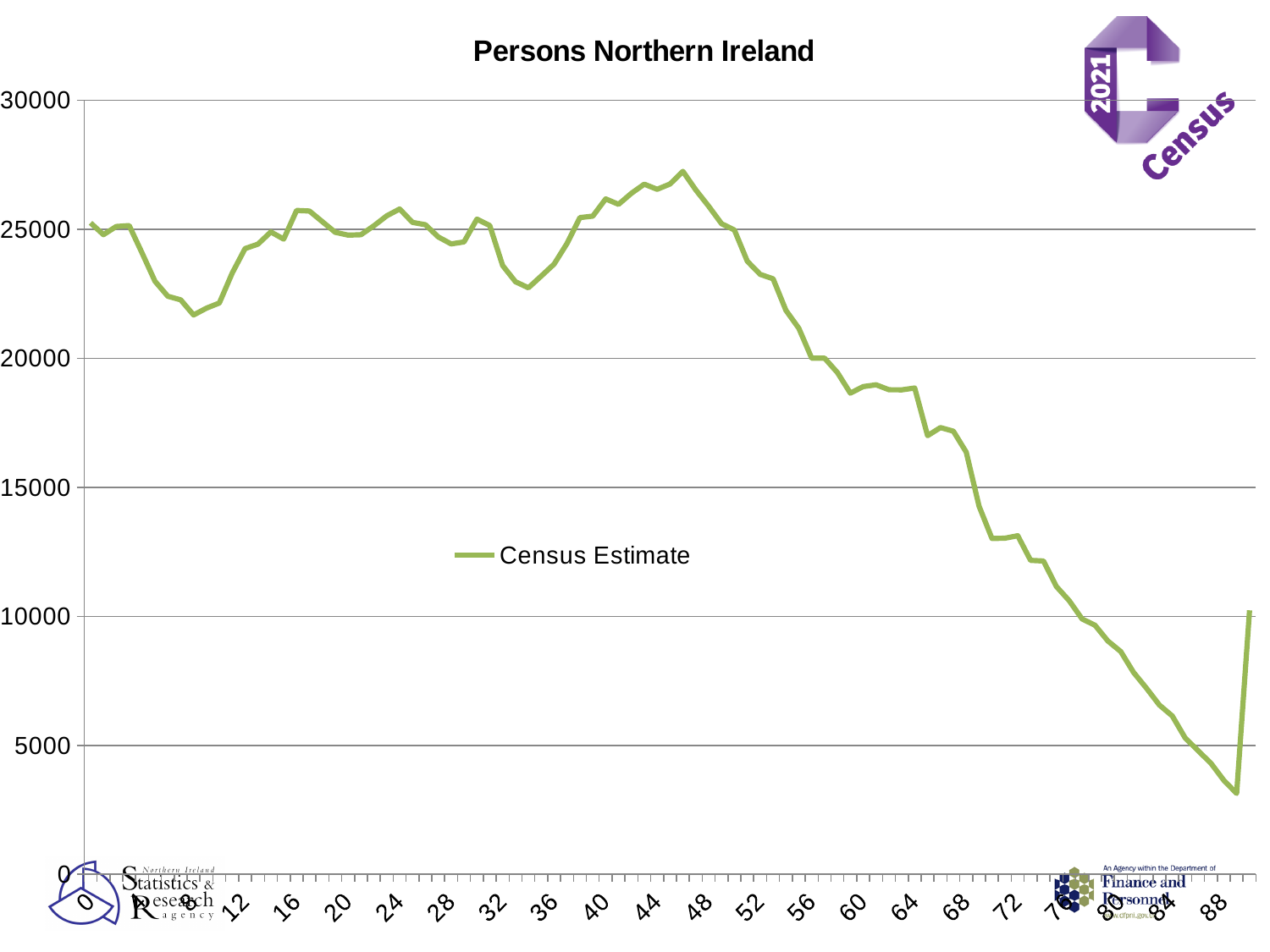
Is the Census Estimate value at age 20 greater or less than 20000? greater Is the Census Estimate value at age 80 greater or less than 10000? less What is the title of the chart? Persons Northern Ireland Do the Census Estimate values rise or fall between age 48 and age 88? fall What kind of chart is shown on the slide? line chart Is the Census Estimate value at age 0 greater or less than 20000? greater What is the name of the series shown in the legend? Census Estimate Which has the larger Census Estimate value, age 44 or age 64? age 44 How many series does the legend list? 1